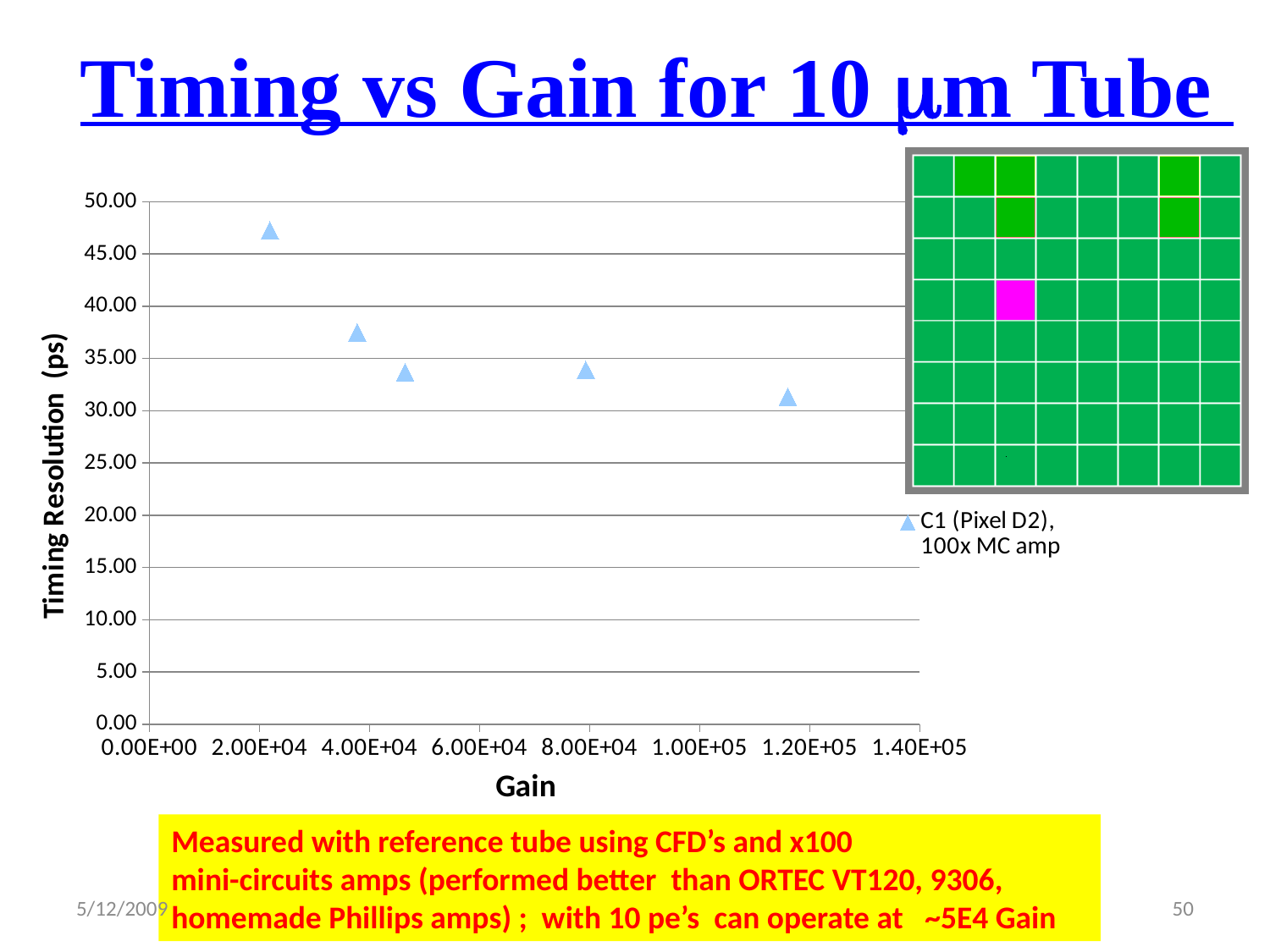
Is the timing resolution for the point near a gain of 4.00E+04 greater or less than 35.00? greater How many data points are plotted in the chart? 5 Which point has the highest timing resolution: the one near a gain of 2.00E+04 or the one near 1.20E+05? The one near 2.00E+04 What kind of chart is shown on the slide? Scatter chart Is the timing resolution for the point near a gain of 8.00E+04 greater or less than 30.00? greater Do the timing resolution values generally rise or fall as gain increases along the x axis? Fall Is the timing resolution for the point near a gain of 2.00E+04 greater or less than 45.00? greater What is the title of the vertical axis? Timing Resolution (ps) Which plotted point has the lowest timing resolution? The point at the highest gain (near 1.20E+05) What is the legend entry for the plotted series? C1 (Pixel D2), 100x MC amp How many series does the chart legend list? 1